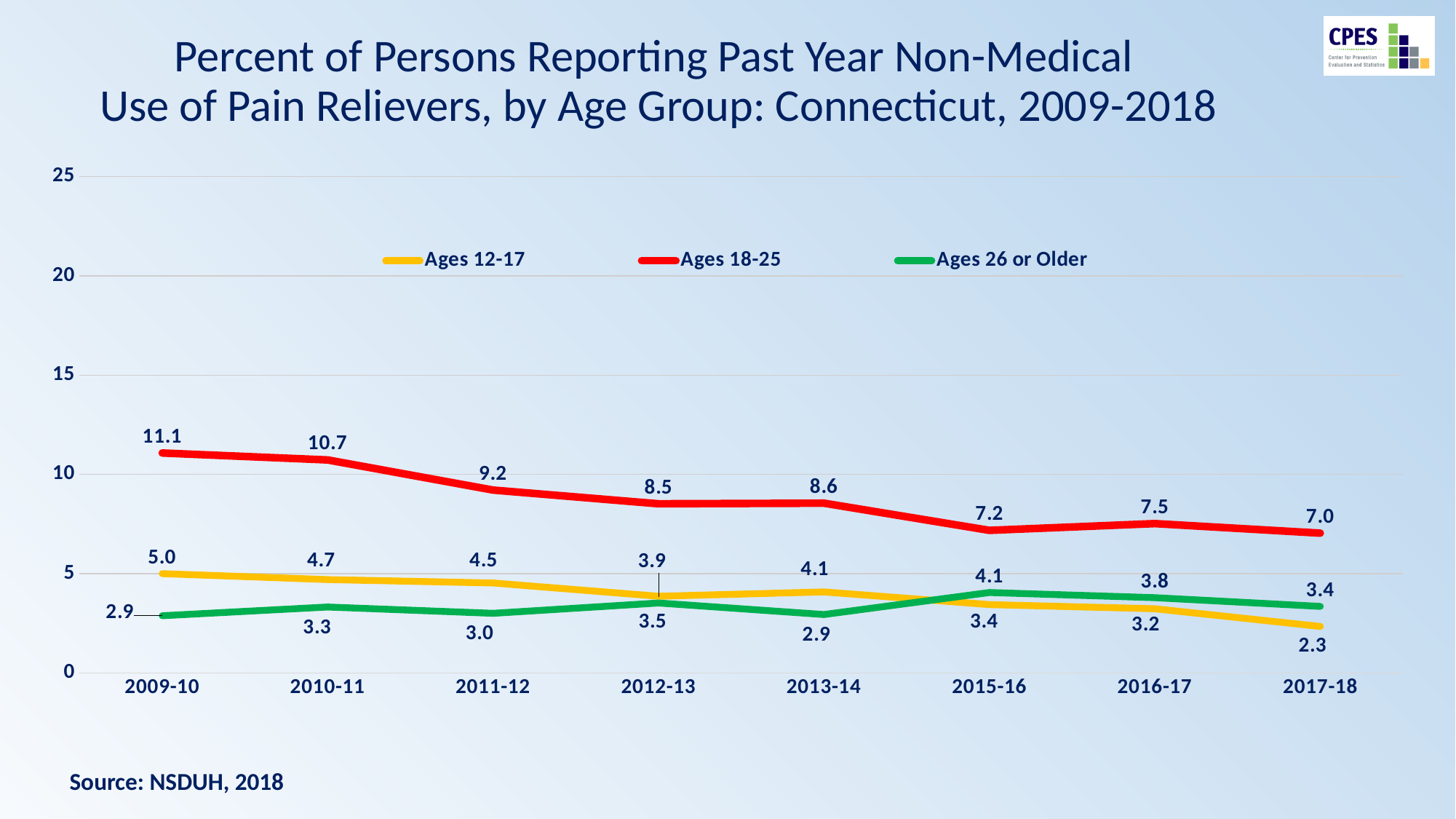
How many series does the legend list? 3 What is the value for Ages 12-17 in 2017-18? 2.3 Which is larger in 2015-16: the value for Ages 12-17 or Ages 26 or Older? Ages 26 or Older How many periods are shown on the x axis? 8 Does the value for Ages 18-25 generally rise or fall from 2009-10 to 2017-18? fall What is the difference between the Ages 18-25 values in 2009-10 and 2017-18? 4.1 What kind of chart is shown? line chart What is the value for Ages 18-25 in 2009-10? 11.1 Is the value for Ages 18-25 in 2011-12 greater or less than 10? less What is the value for Ages 26 or Older in 2015-16? 4.1 In which period is the value for Ages 12-17 the highest? 2009-10 In which period is the value for Ages 18-25 the lowest? 2017-18